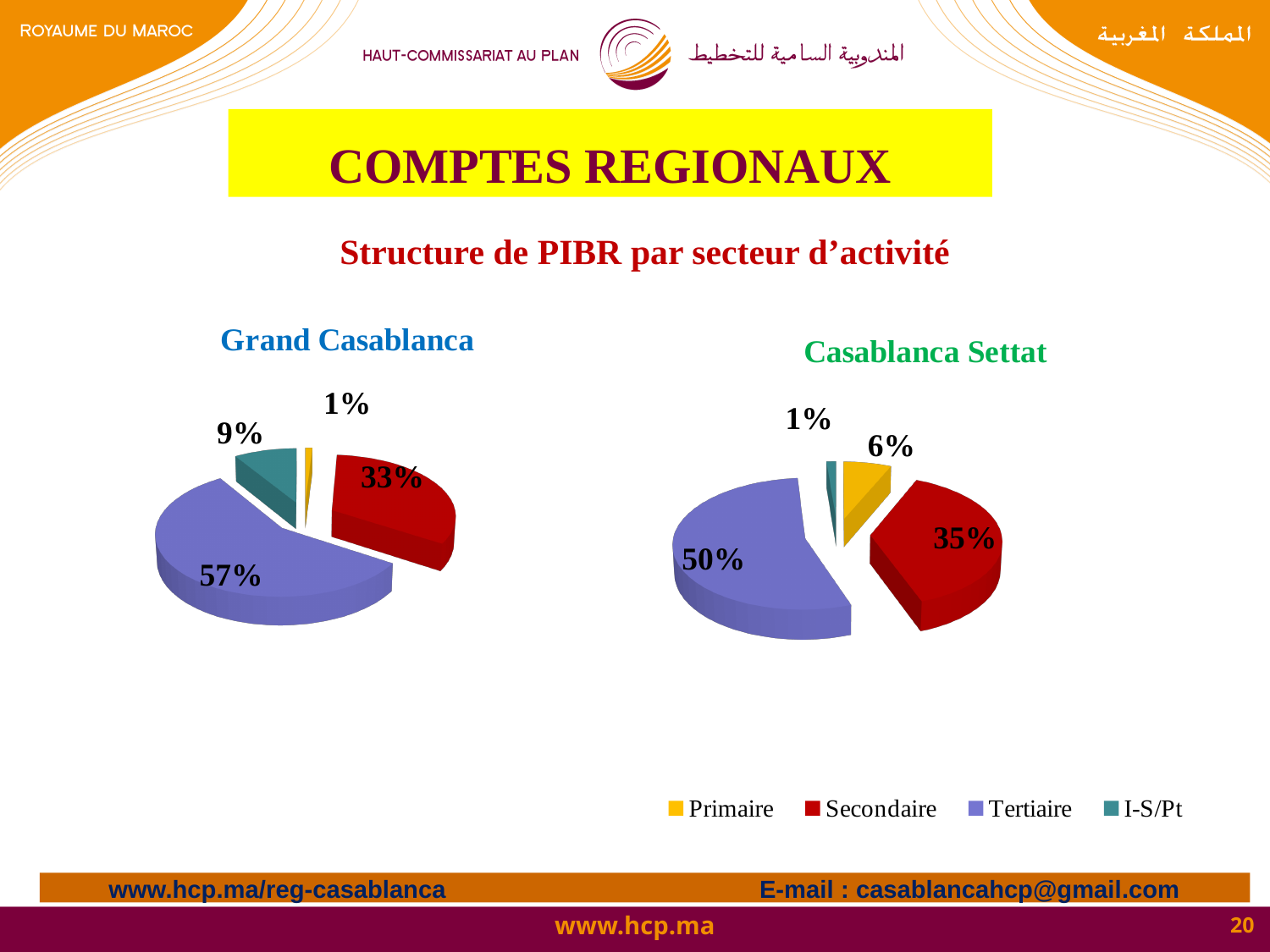
In the Grand Casablanca pie chart, what share does Tertiaire have? 57% What kind of chart is used for Grand Casablanca and Casablanca Settat? Pie chart In the Casablanca Settat pie chart, what share does Secondaire have? 35% In the Grand Casablanca pie chart, which sector has the largest share? Tertiaire Which is larger: the Secondaire share in the Grand Casablanca chart or the Secondaire share in the Casablanca Settat chart? Casablanca Settat In the Casablanca Settat pie chart, what share does Primaire have? 6% In the Casablanca Settat pie chart, which sector has the smallest share? I-S/Pt In the Grand Casablanca pie chart, what is the combined share of Primaire and I-S/Pt? 10% How many sectors does the legend list? 4 Which colour represents Secondaire in the legend? Red What is the difference between the Tertiaire share in the Grand Casablanca chart and the Tertiaire share in the Casablanca Settat chart? 7 percentage points In the Grand Casablanca pie chart, what share does I-S/Pt have? 9%